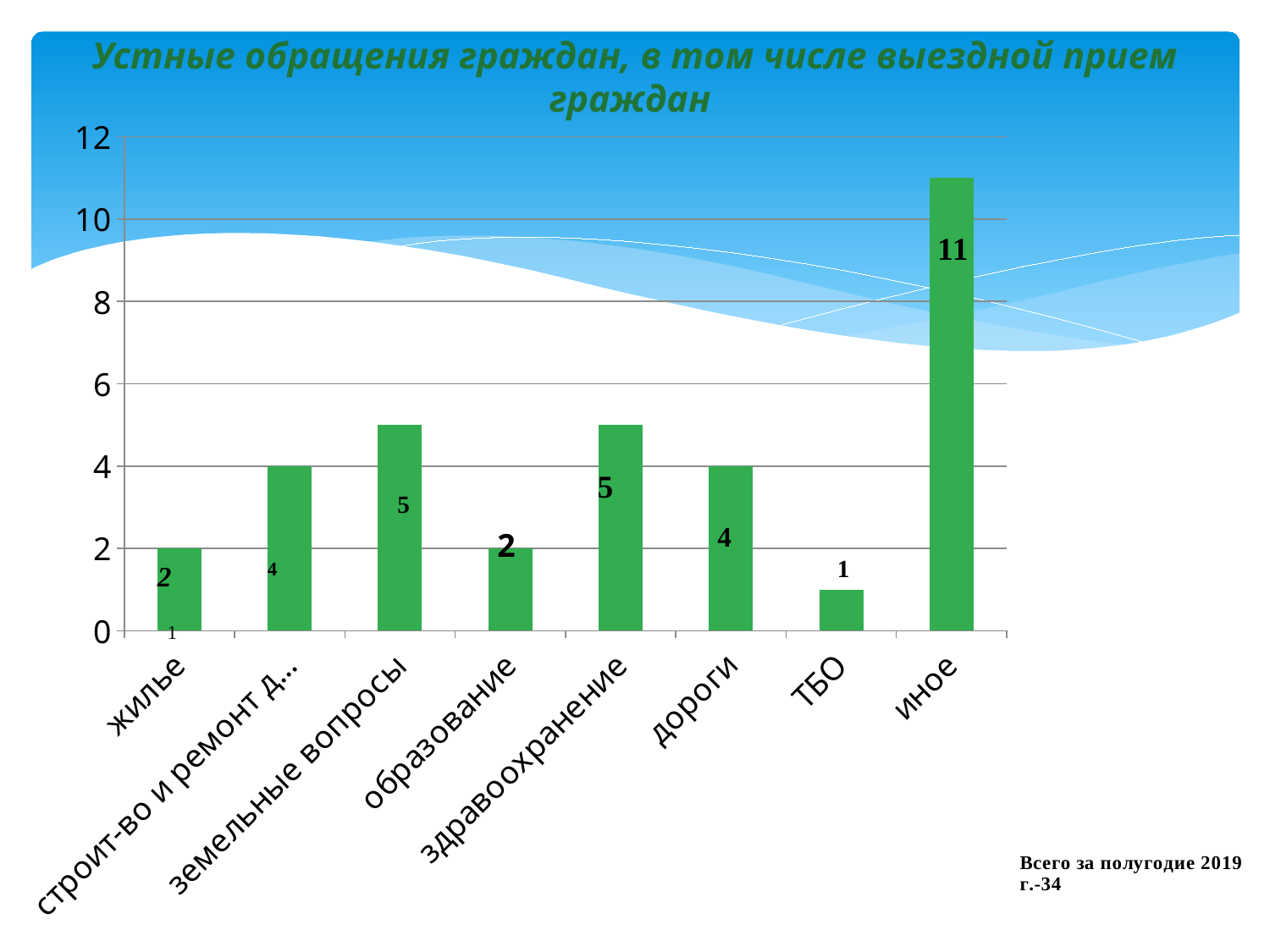
What is the value for ТБО? 1 What type of chart is shown on the slide? bar chart Which category has the highest value? иное What is the value for здравоохранение? 5 What is the difference between the values for иное and земельные вопросы? 6 What is the value for дороги? 4 How many categories are shown on the x axis? 8 Which is larger, the value for дороги or the value for образование? дороги What is the title of the chart? Устные обращения граждан, в том числе выездной прием граждан Which category has the lowest value? ТБО Is the value for иное greater or less than 10? greater What is the value for иное? 11